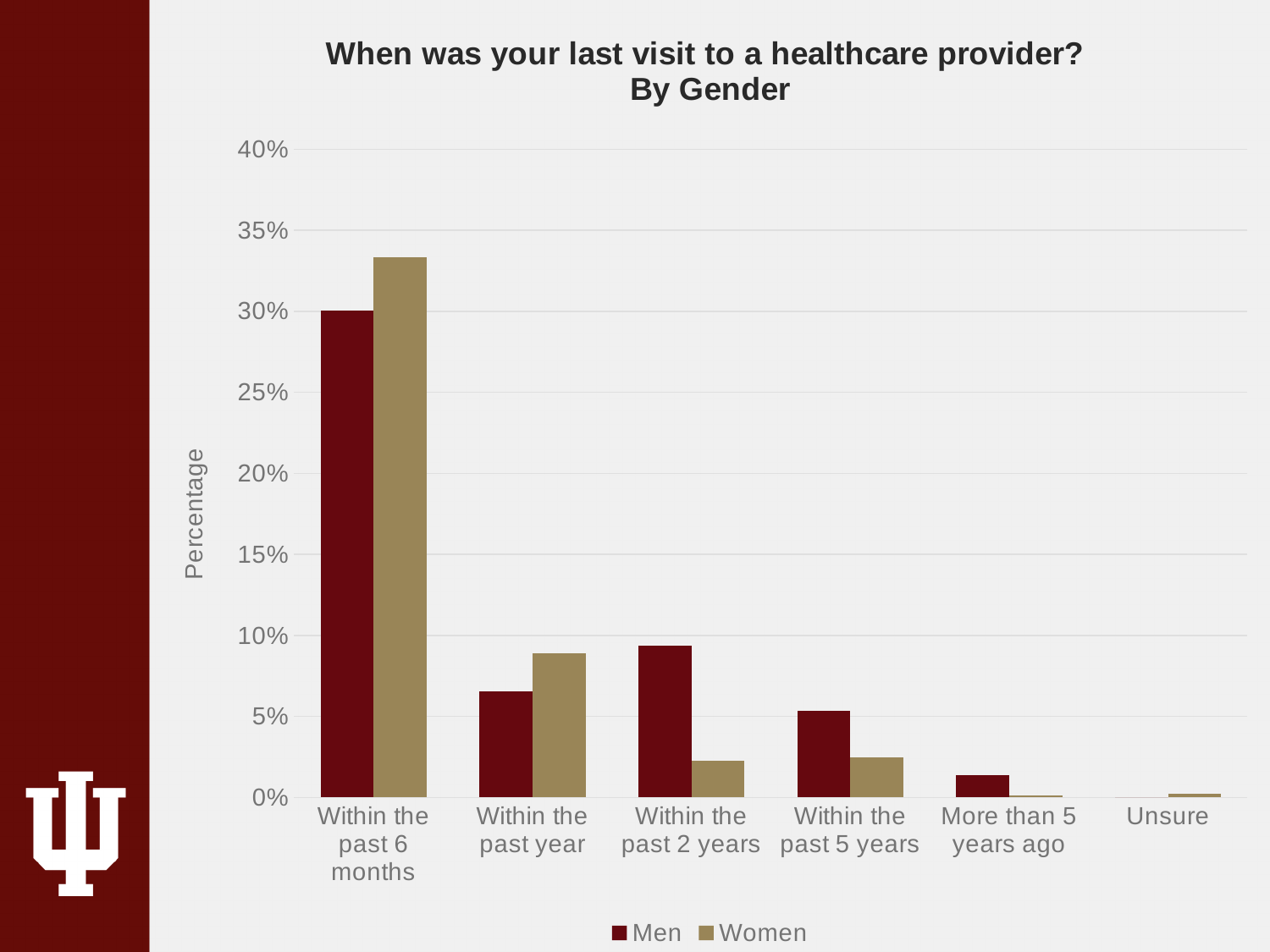
What kind of chart is shown on the slide? bar chart Which category has the lowest value for Men? Unsure In the 'Within the past 2 years' category, which is larger, the value for Men or for Women? Men How many categories are shown on the x axis? 6 In the 'Within the past year' category, which is larger, the value for Men or for Women? Women How many series does the legend list? 2 Which category has the highest value for Men? Within the past 6 months Is the value for Women in the 'Within the past 6 months' category greater or less than 30%? greater Is the value for Men in the 'Within the past 2 years' category greater or less than 10%? less What is the label of the y axis? Percentage Which category has the highest value for Women? Within the past 6 months Is the value for Women in the 'Within the past year' category greater or less than 5%? greater